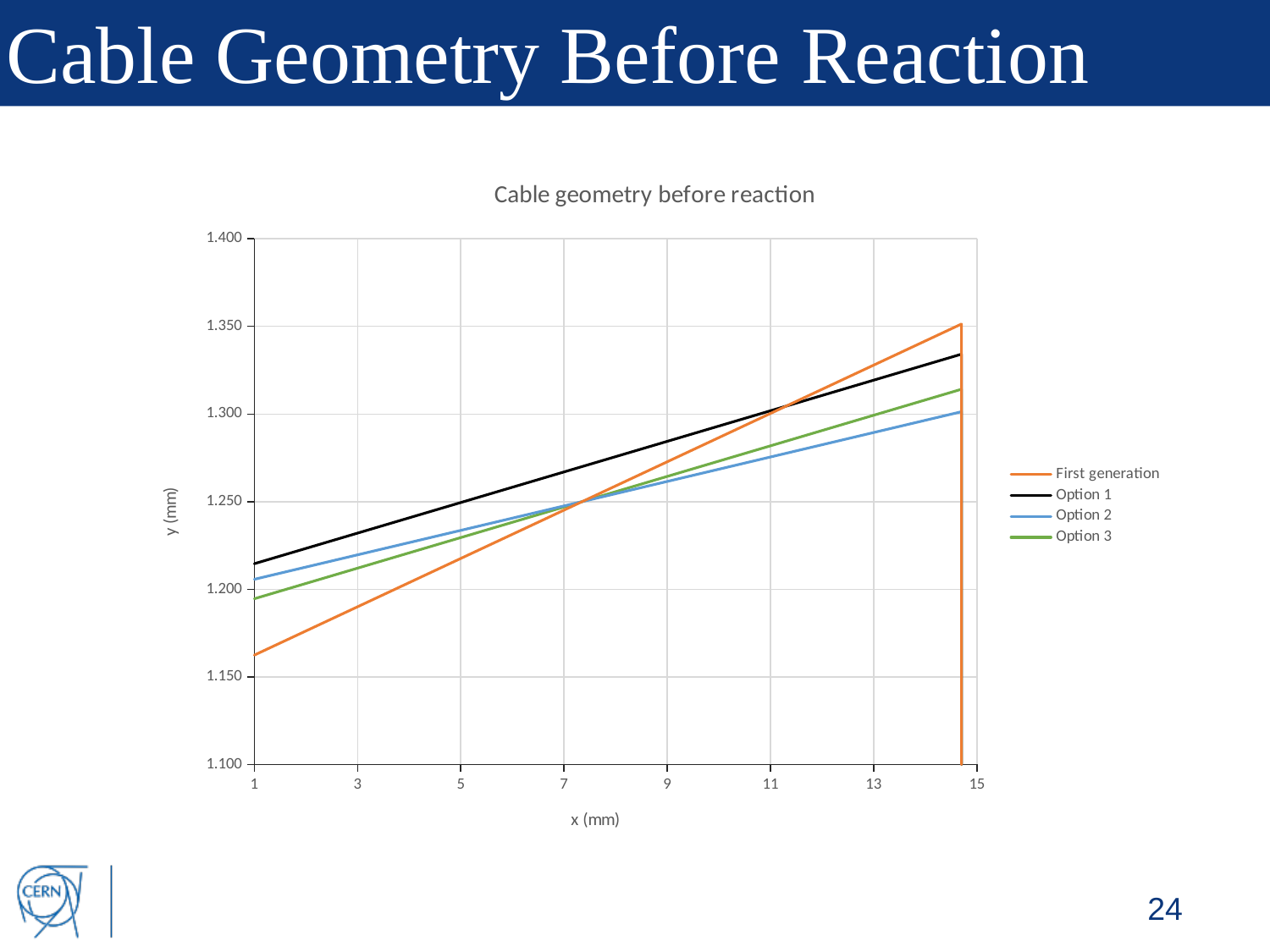
Which series has the lowest value at x = 1? First generation What kind of chart is shown on the slide? line chart Is the value of the Option 1 series at x = 1 greater or less than 1.200? greater Do the values of the First generation series rise or fall as x increases? rise Which series has the highest value at x = 1? Option 1 Is the value of the Option 1 series at its right end (near x = 15) greater or less than 1.350? less What is the title of the chart? Cable geometry before reaction What is the label of the vertical axis? y (mm) How many series does the legend list? 4 At x = 13, which is larger: the First generation series or the Option 2 series? First generation Is the value of the First generation series at x = 1 greater or less than 1.200? less Do the values of the Option 1 series rise or fall as x increases? rise